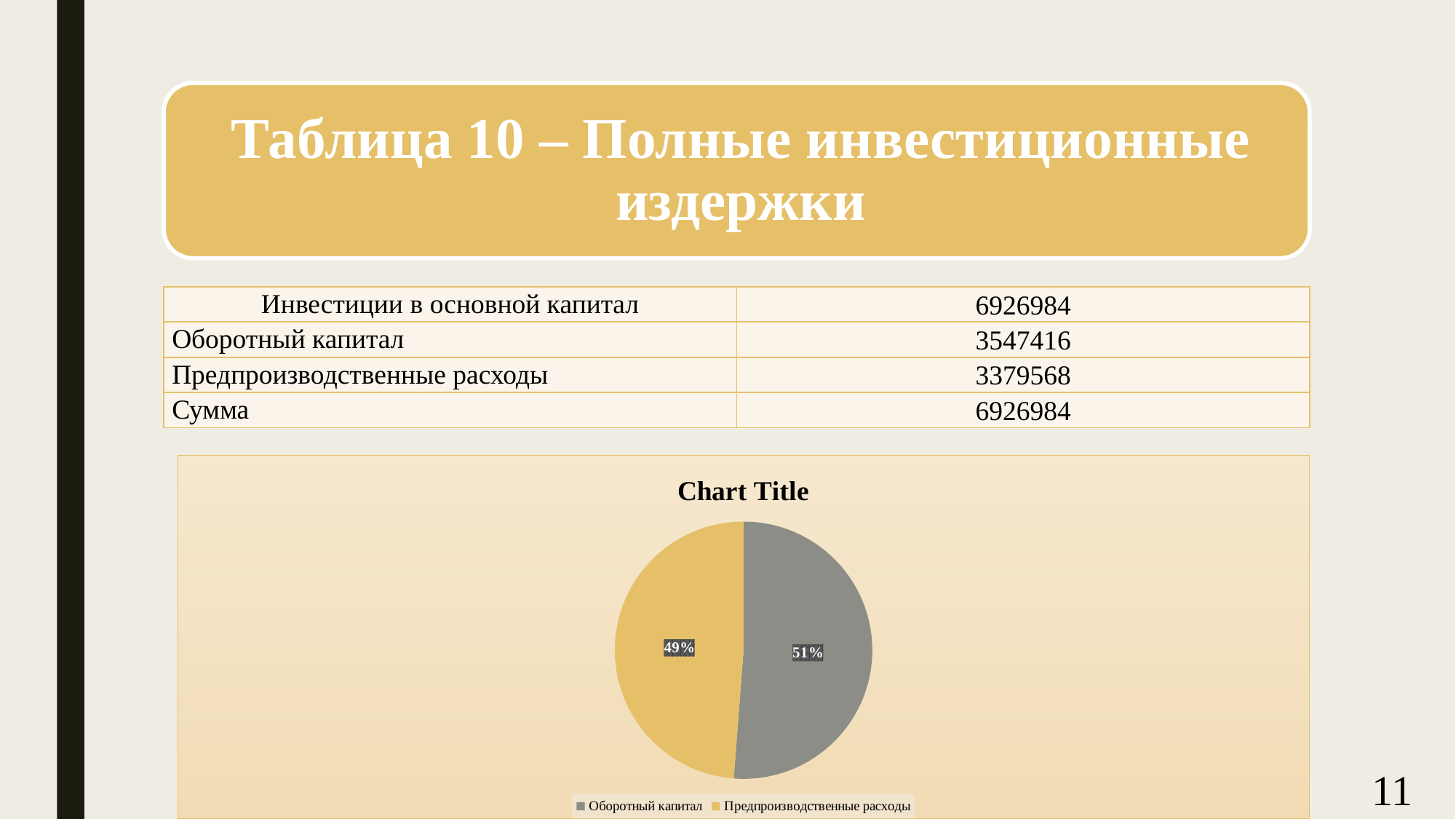
What share of the pie does Предпроизводственные расходы take? 49% What kind of chart is shown on the slide? pie chart How many entries does the chart legend list? 2 What share of the pie does Оборотный капитал take? 51% Which colour represents Предпроизводственные расходы in the pie chart? gold What is the title of the chart? Chart Title How many slices does the pie chart have? 2 By how many percentage points does the Оборотный капитал slice exceed the Предпроизводственные расходы slice? 2 Which category has the largest slice of the pie? Оборотный капитал Which is larger, the slice for Оборотный капитал or the slice for Предпроизводственные расходы? Оборотный капитал Which category has the smallest slice of the pie? Предпроизводственные расходы What is the data label shown on the grey slice? 51%